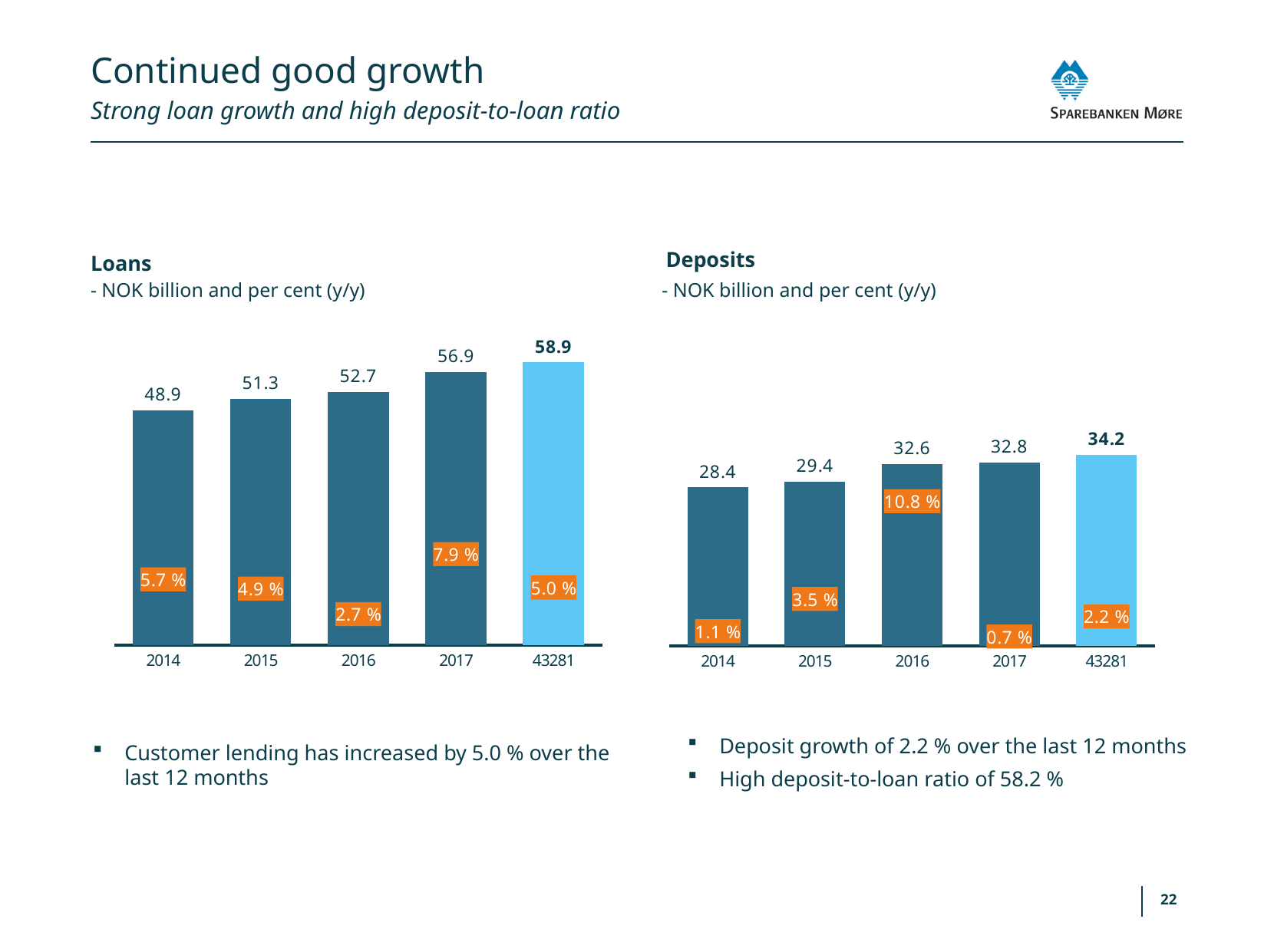
In the Deposits chart, which year has the lowest growth percentage? 2017 In the Loans chart, what is the difference between the 2017 value and the 2014 value? 8.0 In the Deposits chart, what is the value for 2015? 29.4 What type of chart is the Deposits chart? bar chart In the Loans chart, how many bars are plotted? 5 In the Loans chart, do the loan values rise or fall from 2014 to the last bar? rise In the Deposits chart, what is the growth percentage shown for 2016? 10.8 % In the Loans chart, what is the value for 2016? 52.7 In the Deposits chart, which is larger, the value for 2014 or the value for 2015? 2015 In the Deposits chart, what is the difference between the 2016 value and the 2015 value? 3.2 In the Loans chart, which year has the lowest loan value? 2014 In the Loans chart, what is the growth percentage shown for 2017? 7.9 %